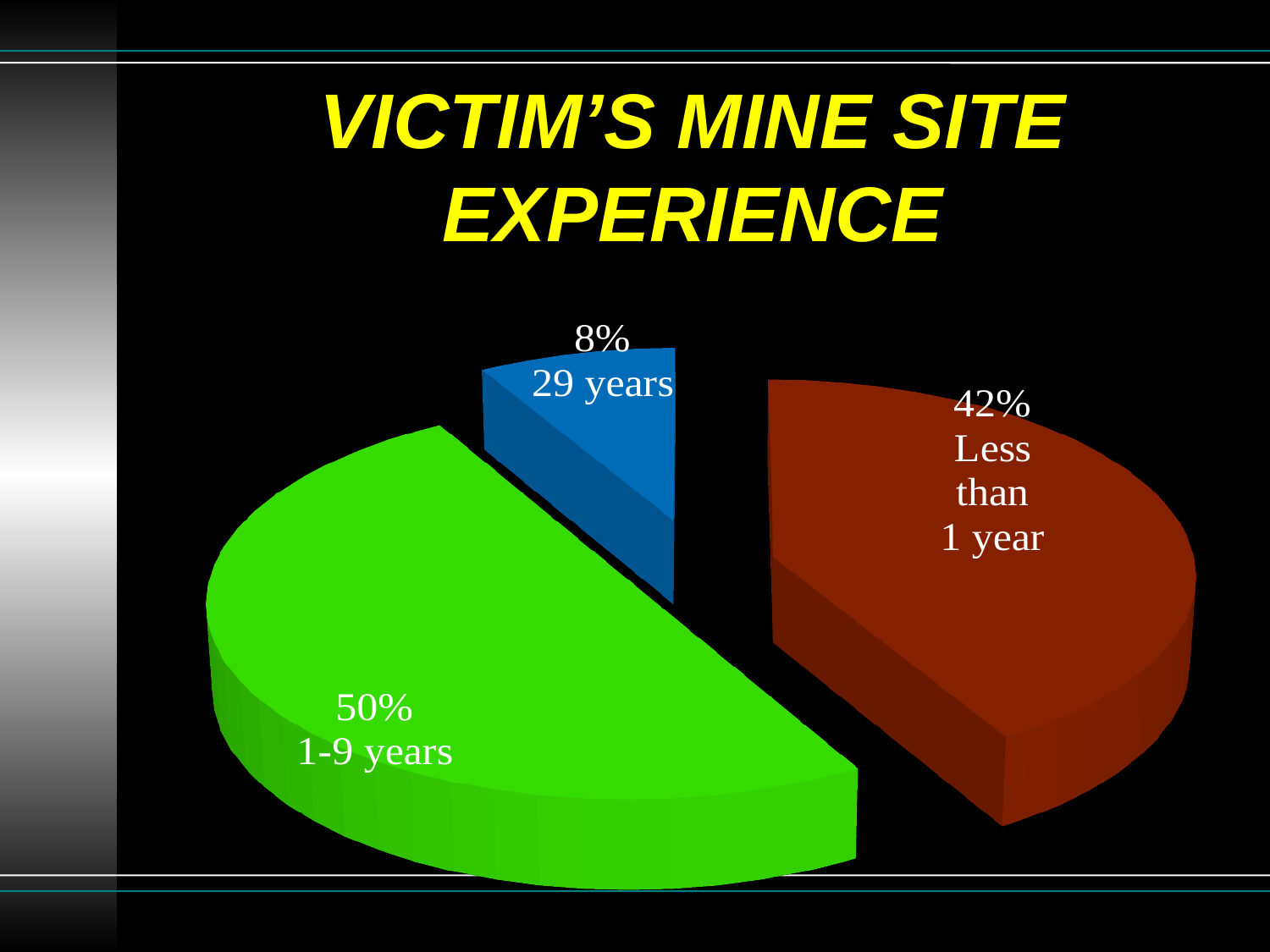
Which category has the largest slice of the pie? 1-9 years What share of the pie is labelled '1-9 years'? 50% What is the difference in percentage points between the 'Less than 1 year' slice and the '29 years' slice? 34% How many slices does the pie chart have? 3 What is the difference in percentage points between the '1-9 years' slice and the 'Less than 1 year' slice? 8% What colour is the slice labelled '29 years'? blue What share of the pie is labelled '29 years'? 8% Which category has the smallest slice of the pie? 29 years What is the title of the slide containing the pie chart? VICTIM'S MINE SITE EXPERIENCE What share of the pie is labelled 'Less than 1 year'? 42% What kind of chart is shown on the slide? pie chart Which is larger, the 'Less than 1 year' slice or the '29 years' slice? Less than 1 year